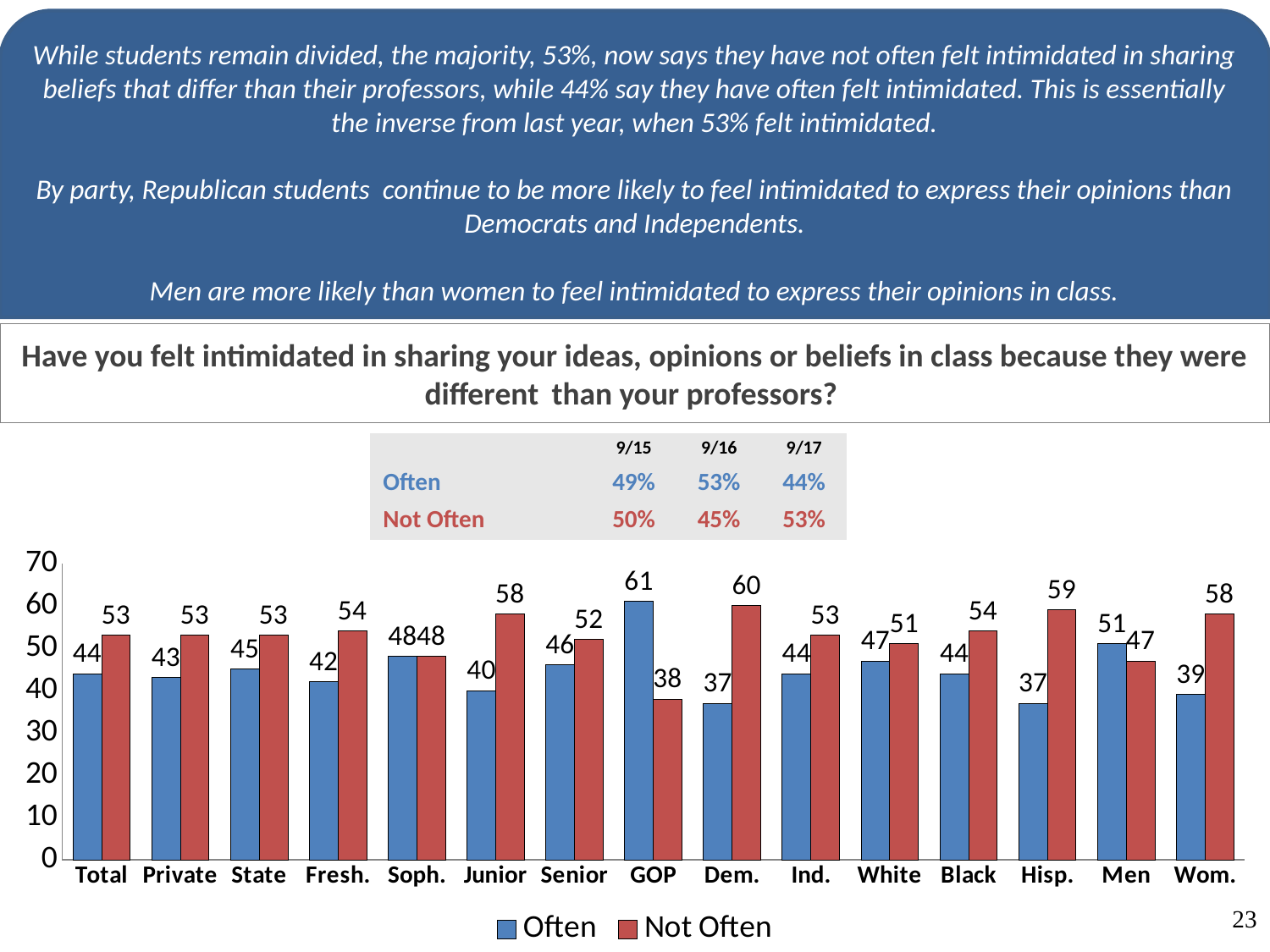
What is the value for Not Often for Junior? 58 Which category has the lowest Not Often value? GOP What colour are the Not Often bars? red What kind of chart is shown on the slide? bar chart How many series does the legend list? 2 What is the value for Often for GOP? 61 Which category has the highest Often value? GOP What is the difference between the Not Often and Often values for Dem.? 23 Which is larger for Men, the Often value or the Not Often value? Often Which category has the highest Not Often value? Dem. What is the value for Often for Wom.? 39 How many categories are shown on the x axis of the bar chart? 15